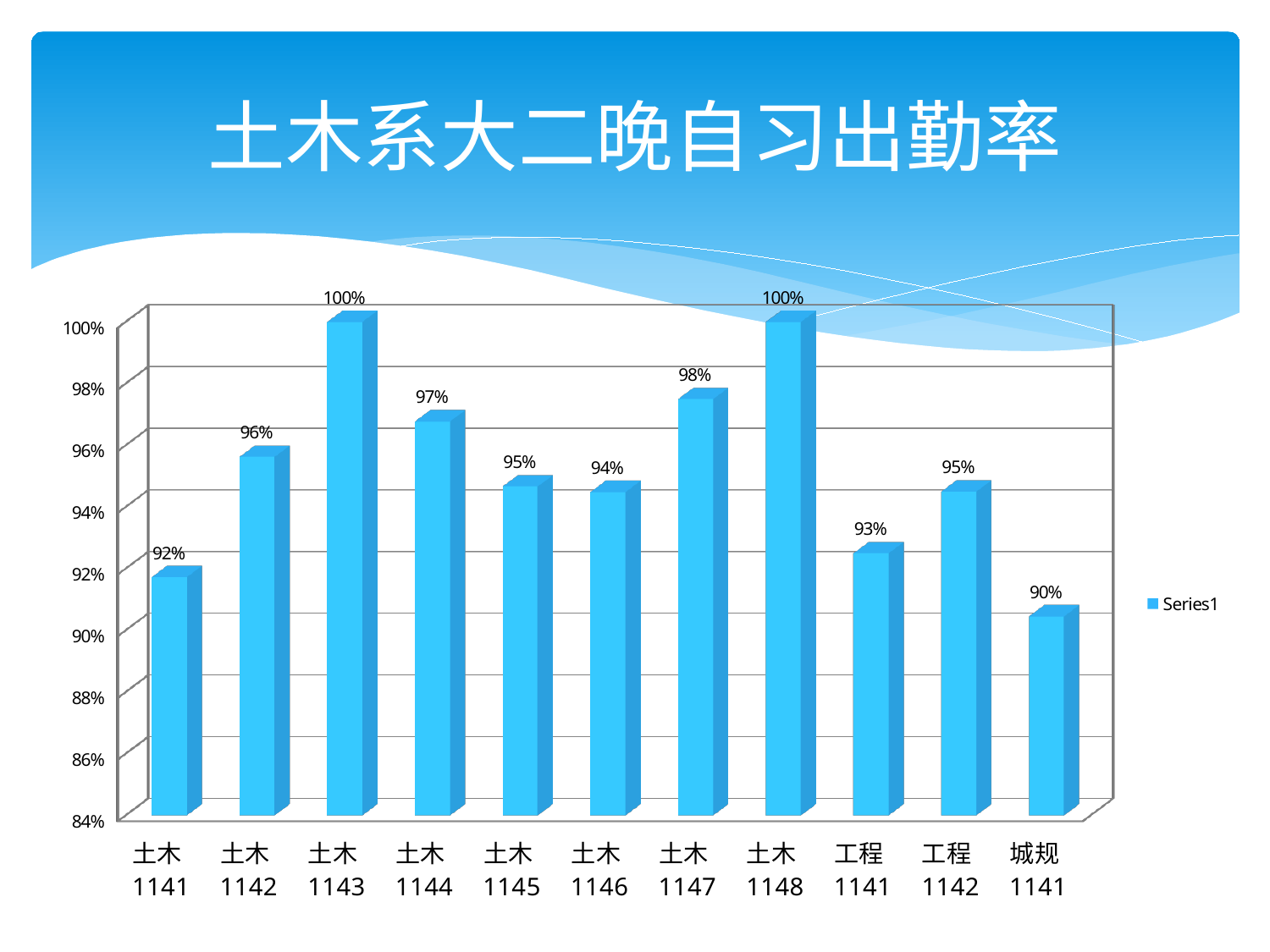
Which categories share the highest value of 100%? 土木1143 and 土木1148 What kind of chart is shown on the slide? bar chart Is the value for 城规1141 greater or less than 92%? less What is the value shown for 土木1147? 98% Which category has the lowest value? 城规1141 What is the value shown for 工程1141? 93% What is the title of the chart? 土木系大二晚自习出勤率 Which is larger, the value for 土木1146 or the value for 工程1142? 工程1142 What is the attendance rate for 土木1142? 96% What is the difference between the values for 土木1144 and 土木1141? 5% How many categories are shown on the x axis? 11 How many series does the legend list? 1